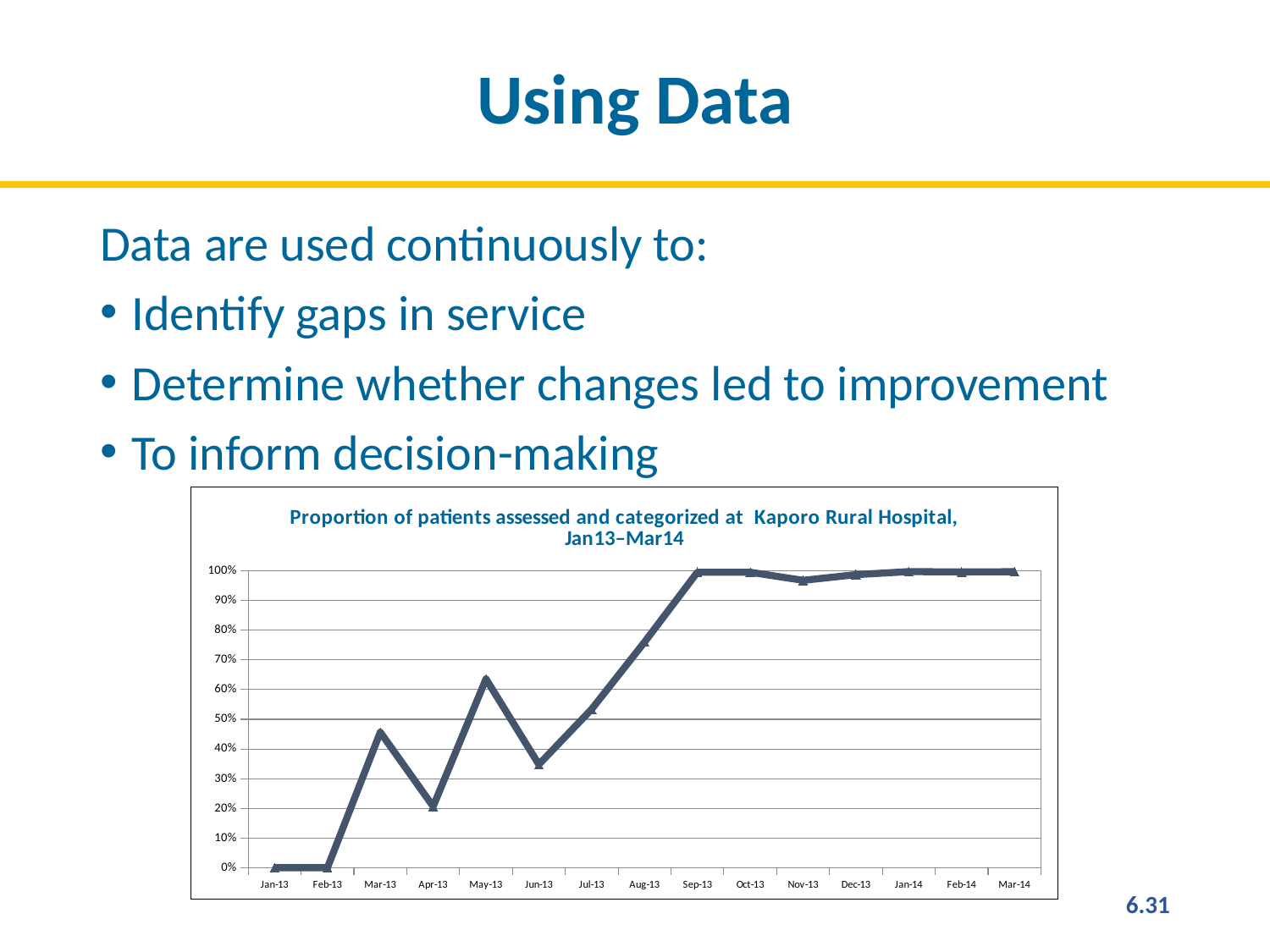
Which month has the higher value, May-13 or Jun-13? May-13 What kind of chart is shown on the slide? line chart Overall, do the values rise or fall from Jan-13 to Mar-14? rise How many months (data points) are plotted on the x axis? 15 What is the value for Jan-13? 0% Is the value for Mar-13 greater or less than 40%? greater Is the value for Aug-13 greater or less than 70%? greater What is the title of the chart? Proportion of patients assessed and categorized at Kaporo Rural Hospital, Jan13–Mar14 Is the value for Jun-13 greater or less than 40%? less What is the value for Feb-13? 0% What is the lowest value shown on the chart? 0%